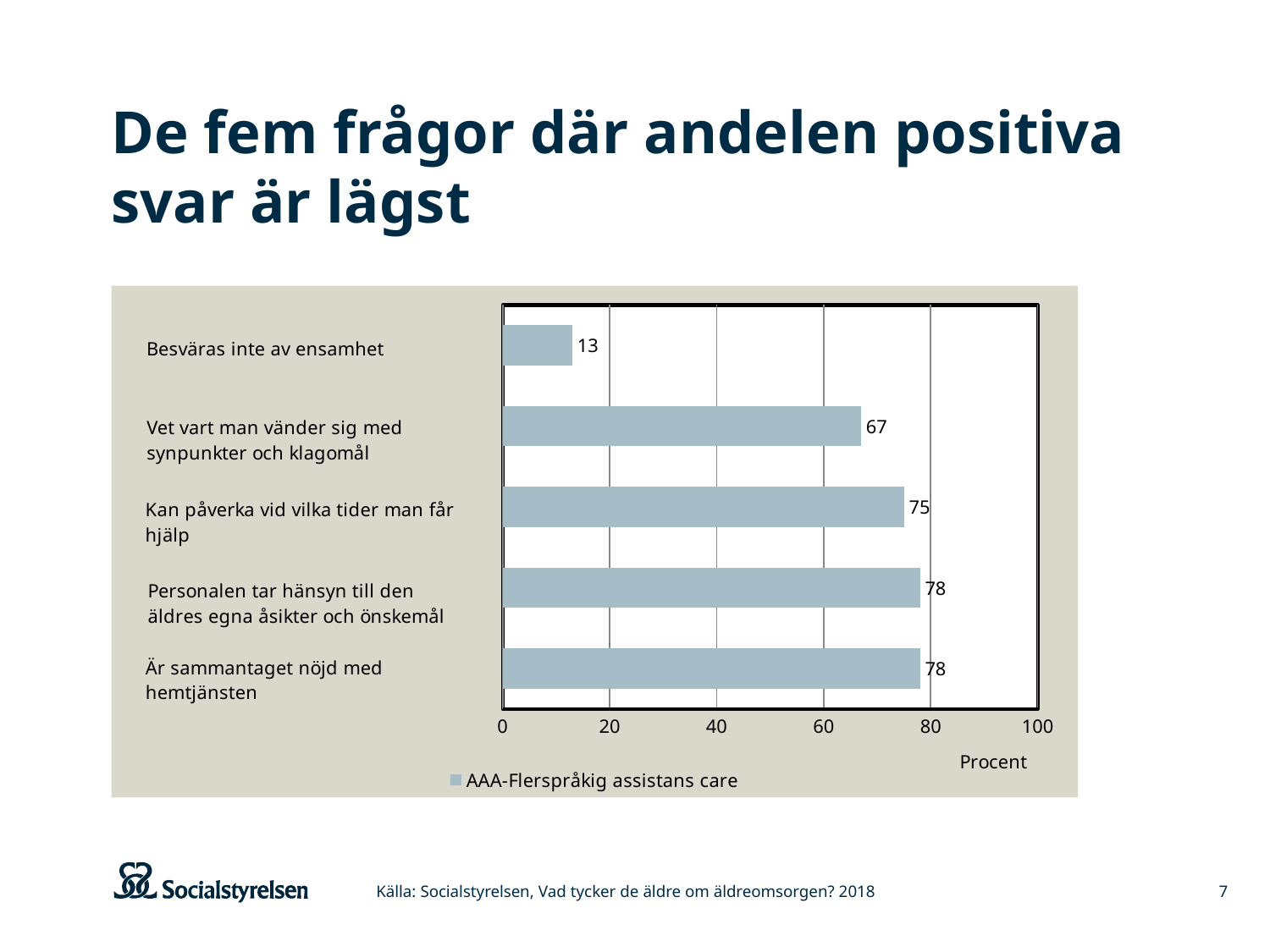
Which category has the lowest value? Besväras inte av ensamhet What is the value for "Kan påverka vid vilka tider man får hjälp"? 75 What kind of chart is shown on the slide? bar chart What is the difference between the values for "Kan påverka vid vilka tider man får hjälp" and "Vet vart man vänder sig med synpunkter och klagomål"? 8 How many categories are shown in the chart? 5 Is the value for "Besväras inte av ensamhet" greater or less than 20? less What series name does the legend show? AAA-Flerspråkig assistans care Which is larger, the value for "Vet vart man vänder sig med synpunkter och klagomål" or the value for "Kan påverka vid vilka tider man får hjälp"? Kan påverka vid vilka tider man får hjälp What is the difference between the values for "Är sammantaget nöjd med hemtjänsten" and "Besväras inte av ensamhet"? 65 What is the value for "Är sammantaget nöjd med hemtjänsten"? 78 What is the value for "Vet vart man vänder sig med synpunkter och klagomål"? 67 What is the value for "Besväras inte av ensamhet"? 13